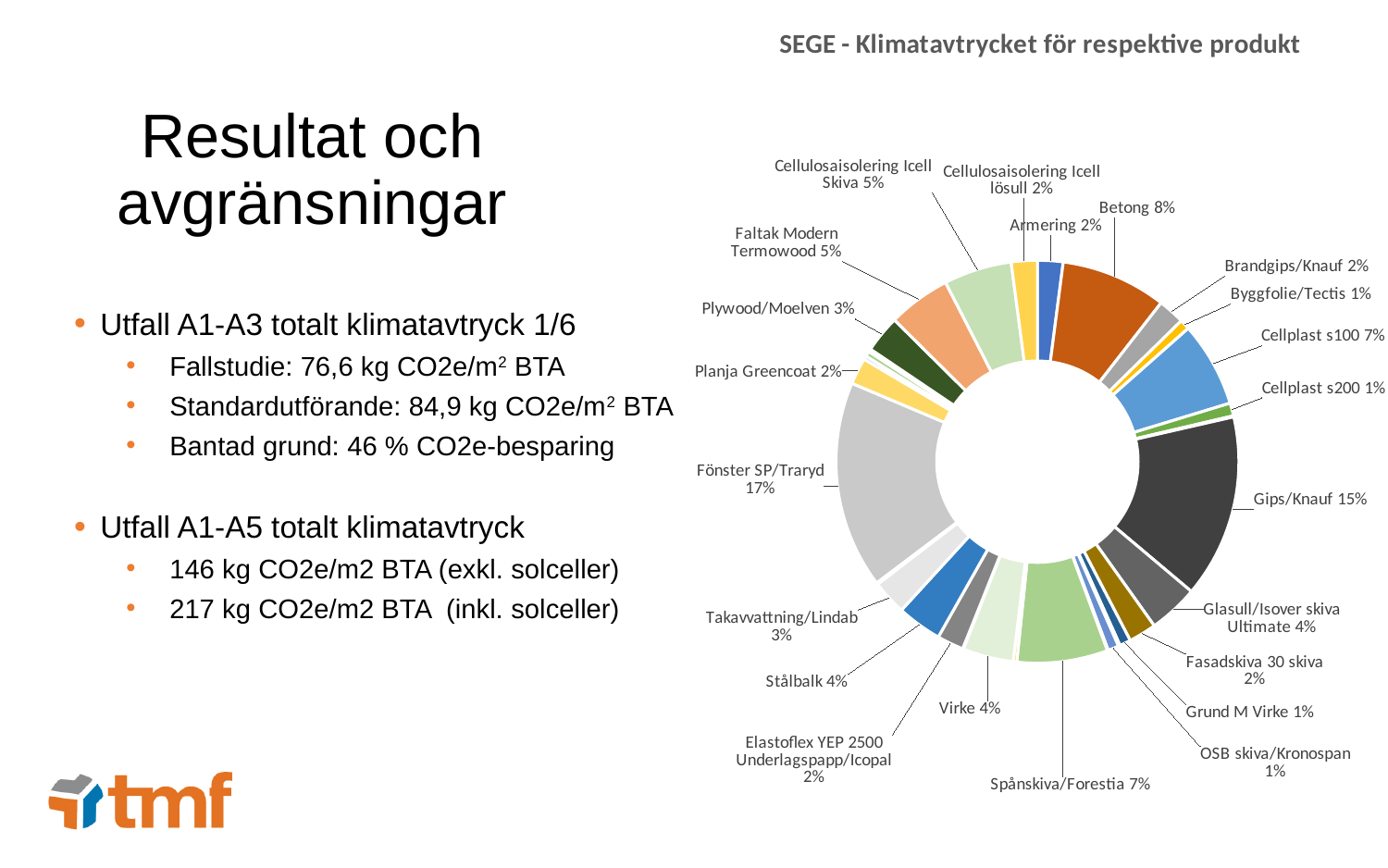
What percentage is shown for Spånskiva/Forestia? 7% What is the difference in percentage points between Fönster SP/Traryd and Gips/Knauf? 2 percentage points What type of chart is shown on the slide? Doughnut chart What share of the chart does Betong account for? 8% Which has a larger share, Betong or Stålbalk? Betong What percentage is shown for Cellplast s100? 7% Which product has the largest share of the climate footprint in the chart? Fönster SP/Traryd What percentage is shown for Faltak Modern Termowood? 5% What share of the chart does Gips/Knauf account for? 15% What percentage is shown for Takavvattning/Lindab? 3% What is the title of the chart? SEGE - Klimatavtrycket för respektive produkt